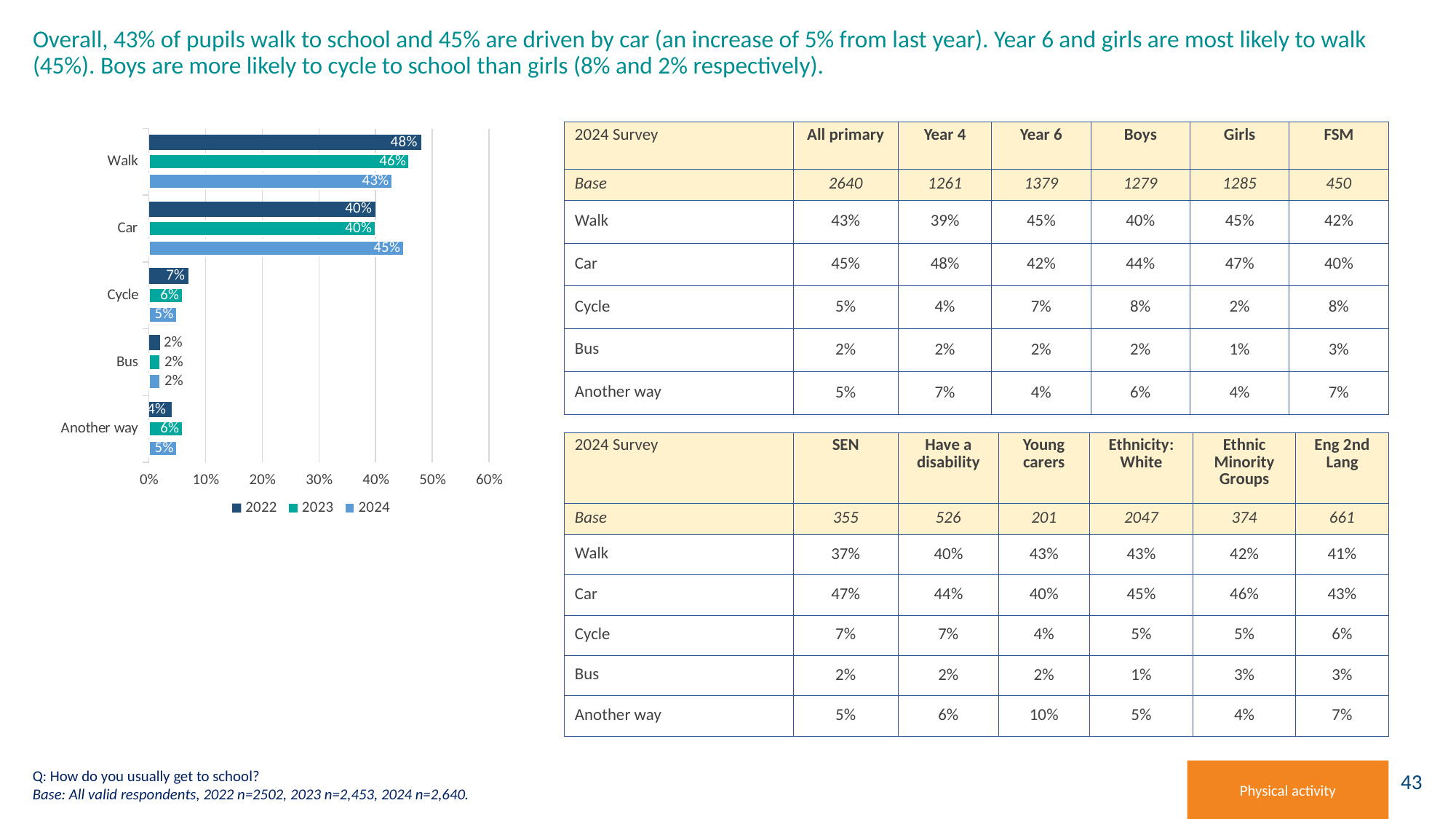
Which category has the lowest value in 2022? Bus What kind of chart is shown on the slide? bar chart What is the value for Car in 2024? 45% How many series does the legend list? 3 What is the difference between the Walk values for 2022 and 2024? 5% What is the value for Another way in 2022? 4% How many categories are shown on the chart? 5 Which category has the highest value in 2024? Car Is the value for Walk in 2023 greater or less than 40%? greater What is the value for Cycle in 2023? 6% What is the value for Walk in 2022? 48% Which is larger, the 2024 value for Walk or the 2024 value for Car? Car